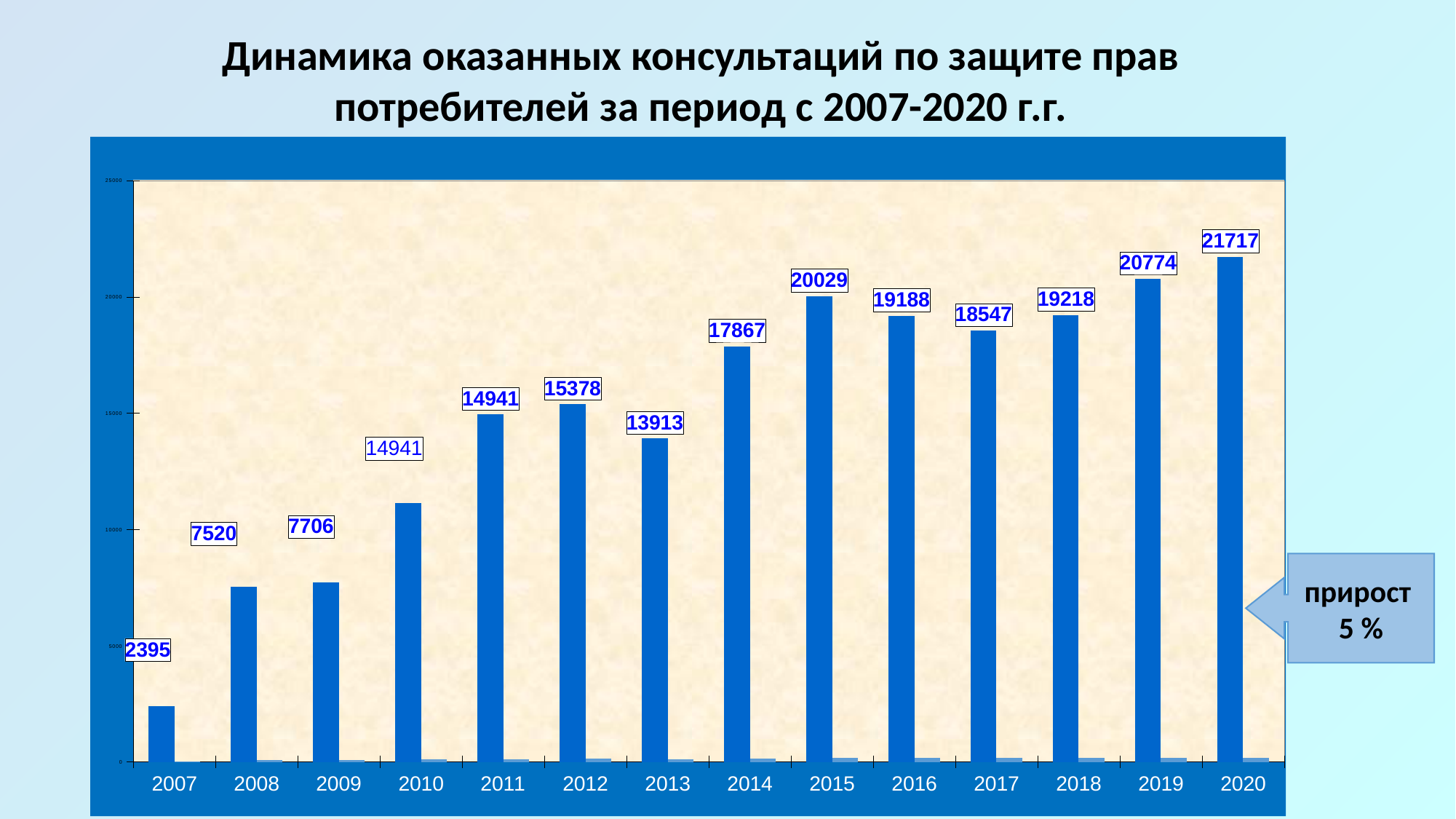
What is the value for 2015? 20029 What is the value for 2020? 21717 Which is larger, the value for 2012 or the value for 2013? 2012 Which year has the highest value? 2020 What kind of chart is shown on the slide? bar chart How many years are shown on the x axis of the chart? 14 Which year has the lowest value? 2007 What is the difference between the values for 2020 and 2019? 943 What is the value for 2007? 2395 What is the difference between the values for 2015 and 2014? 2162 Is the value for 2010 greater or less than 10000? greater What growth percentage is stated in the arrow callout next to the chart? 5 %